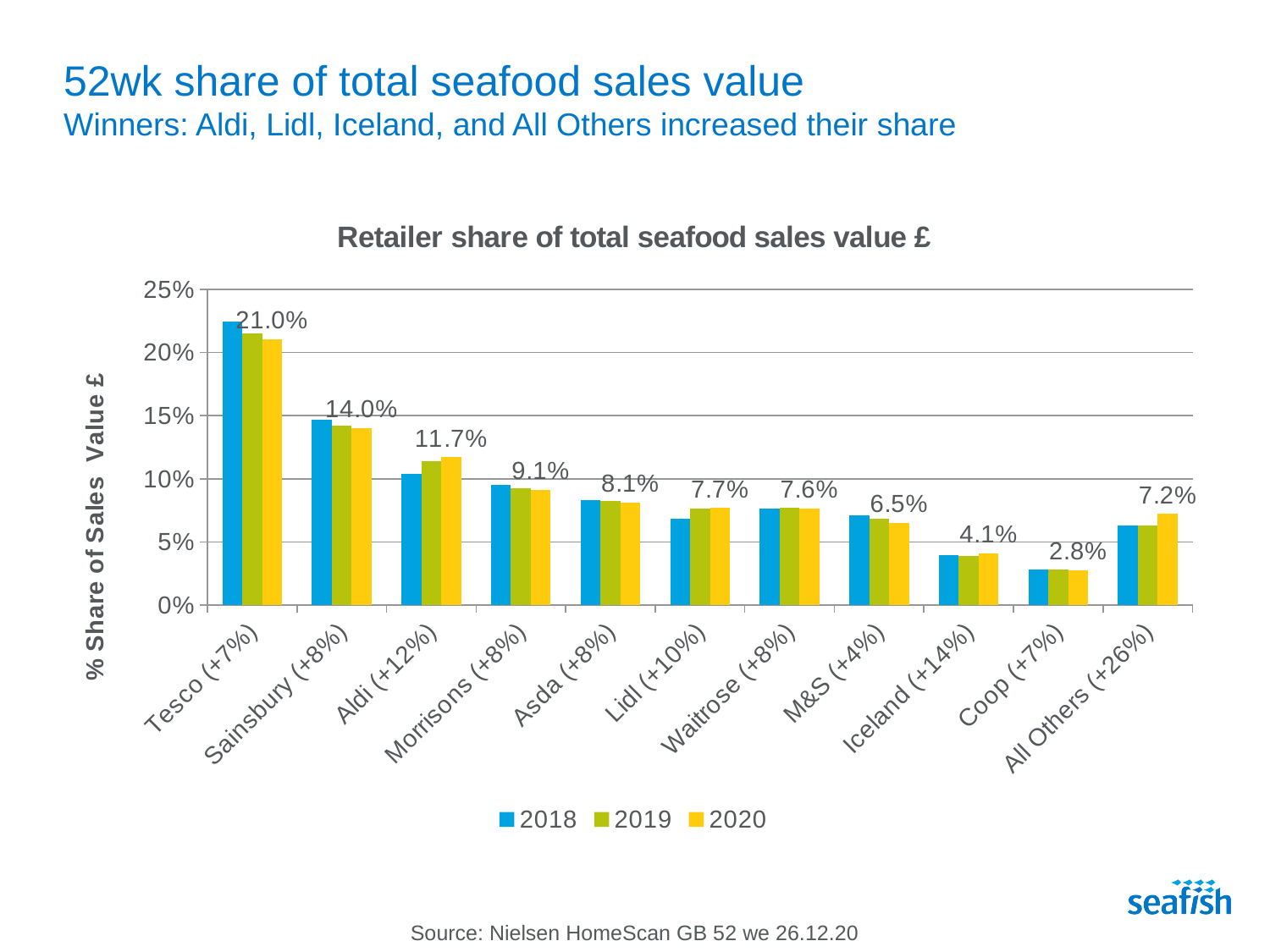
Is the 2018 value for Tesco greater or less than 20%? greater How many series does the legend list? 3 Which retailer has the lowest 2020 share of seafood sales value? Coop What is the 2020 share for All Others? 7.2% Which retailer has the highest 2020 share of seafood sales value? Tesco How many retailer categories are shown on the x axis? 11 Which has the larger 2020 share, Morrisons or Asda? Morrisons What is the 2020 share for Aldi? 11.7% What is the difference between the 2020 shares of Sainsbury and Aldi? 2.3% What kind of chart is shown on the slide? Bar chart What is the 2020 share of total seafood sales value for Tesco? 21.0% Do Tesco's bars rise or fall from 2018 to 2020? Fall